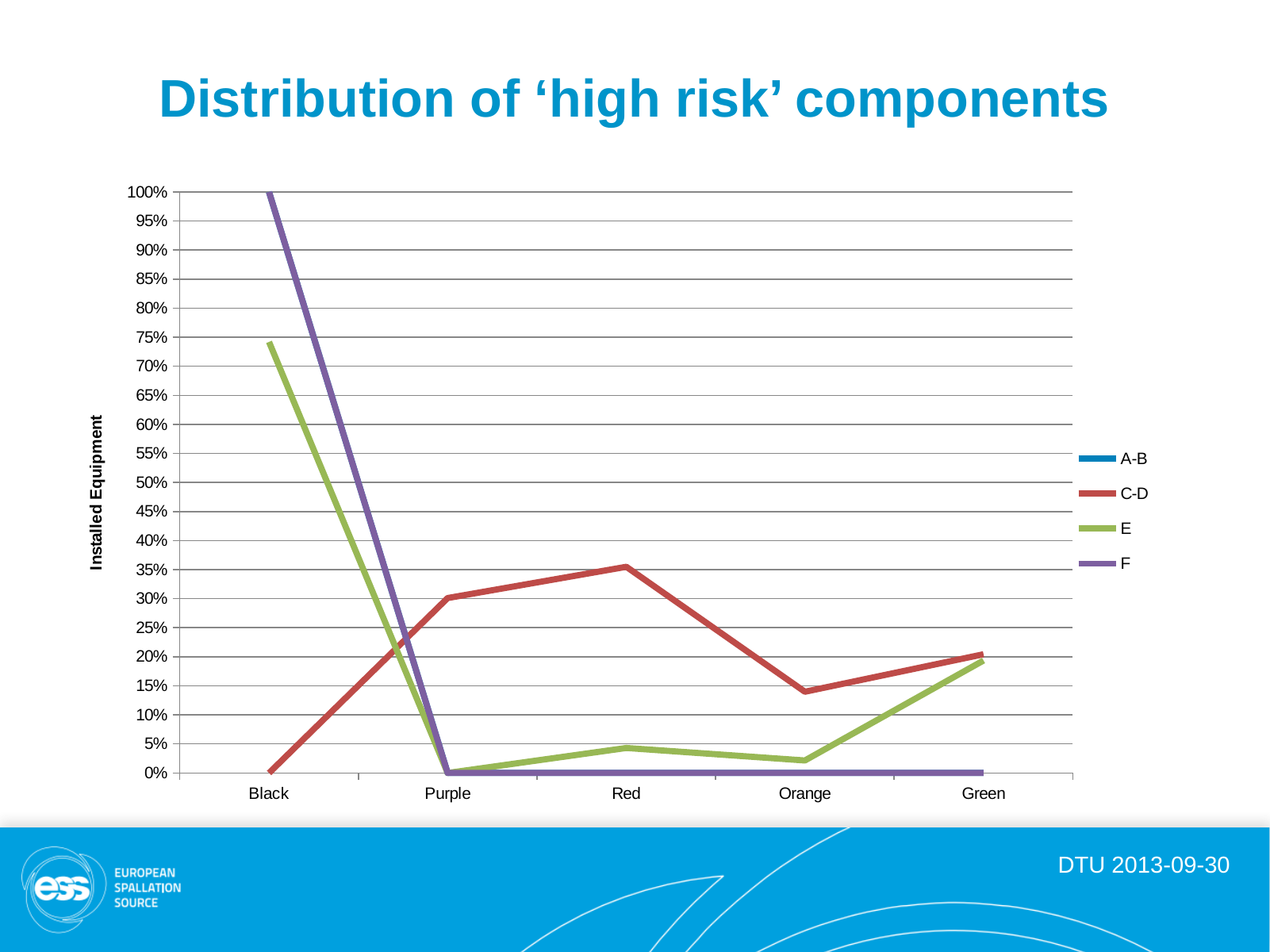
How many series does the legend list? 4 What is the value of series F for Black? 100% Is the value of series C-D for Red greater or less than 30%? greater What is the title of the vertical axis? Installed Equipment Is the value of series E for Black greater or less than 70%? greater How many categories are shown on the x axis? 5 What is the value of series C-D for Black? 0% For which category is series C-D highest? Red What kind of chart is shown on the slide? line chart Is the value of series C-D for Orange greater or less than 20%? less What is the value of series F for Green? 0% For Black, which series has the larger value, E or F? F